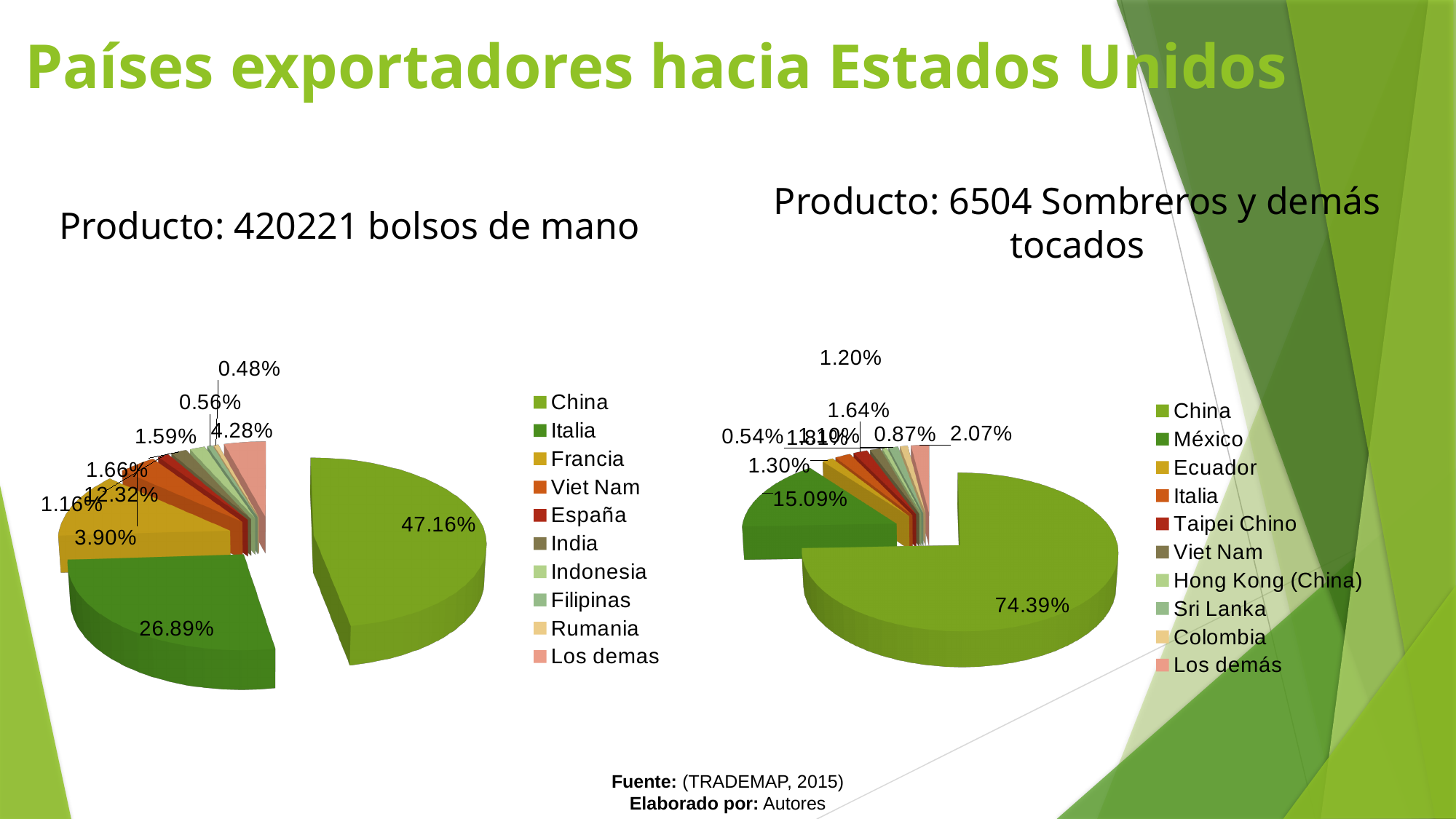
On the chart titled 'Producto: 6504 Sombreros y demás tocados', which legend entry is listed second? México On the chart titled 'Producto: 420221 bolsos de mano', what share does Francia have? 12.32% On the chart titled 'Producto: 420221 bolsos de mano', what is the difference between the shares of China and Italia? 20.27% On the chart titled 'Producto: 6504 Sombreros y demás tocados', what share does China have? 74.39% On the chart titled 'Producto: 6504 Sombreros y demás tocados', what is the difference between the shares of China and México? 59.30% On the chart titled 'Producto: 420221 bolsos de mano', what share does China have? 47.16% On the chart titled 'Producto: 6504 Sombreros y demás tocados', what share does México have? 15.09% On the chart titled 'Producto: 420221 bolsos de mano', how many categories does the legend list? 10 On the chart titled 'Producto: 6504 Sombreros y demás tocados', which is larger, the share of China or the share of México? China What kind of chart is used on the slide for 'Producto: 6504 Sombreros y demás tocados'? Pie chart On the chart titled 'Producto: 420221 bolsos de mano', which country has the largest share? China On the chart titled 'Producto: 420221 bolsos de mano', what share does Italia have? 26.89%